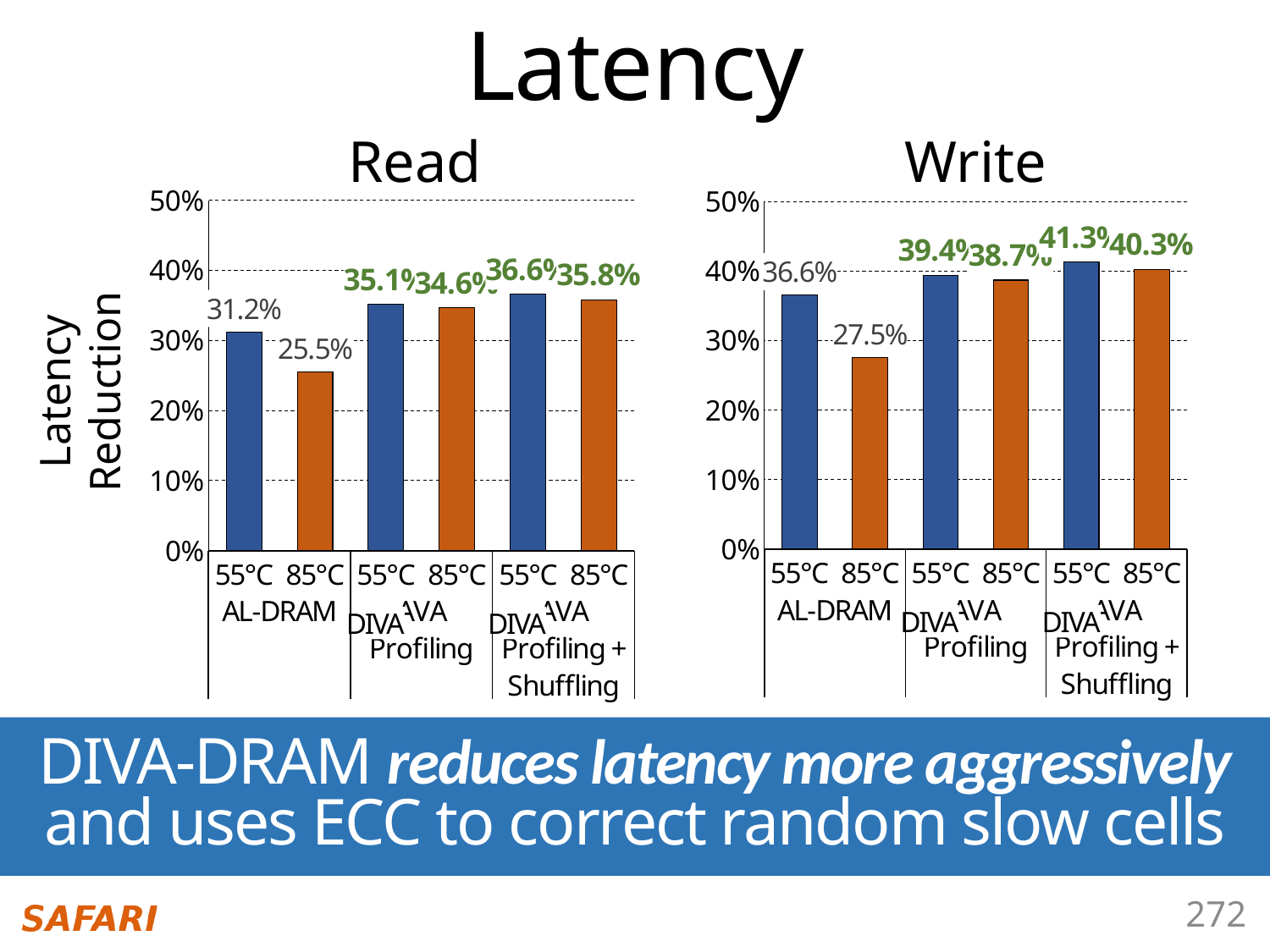
In the Write chart, what is the latency reduction for DIVA Profiling + Shuffling at 55°C? 41.3% How many bars are plotted in the Read chart? 6 In the Write chart, what is the difference between the AL-DRAM latency reduction at 55°C and at 85°C? 9.1% In the Read chart, which bar shows the lowest latency reduction? AL-DRAM at 85°C In the Read chart, which is larger: the latency reduction for DIVA Profiling at 55°C or for AL-DRAM at 85°C? DIVA Profiling at 55°C In the Write chart, which bar shows the highest latency reduction? DIVA Profiling + Shuffling at 55°C In the Write chart, is the latency reduction for AL-DRAM at 85°C greater or less than 30%? less In the Write chart, what is the latency reduction for AL-DRAM at 85°C? 27.5% In the Read chart, what is the difference between the DIVA Profiling + Shuffling latency reduction at 55°C and the AL-DRAM latency reduction at 55°C? 5.4% What kind of chart is the Write chart? bar chart In the Read chart, what is the latency reduction for AL-DRAM at 55°C? 31.2% In the Read chart, what is the latency reduction for AL-DRAM at 85°C? 25.5%